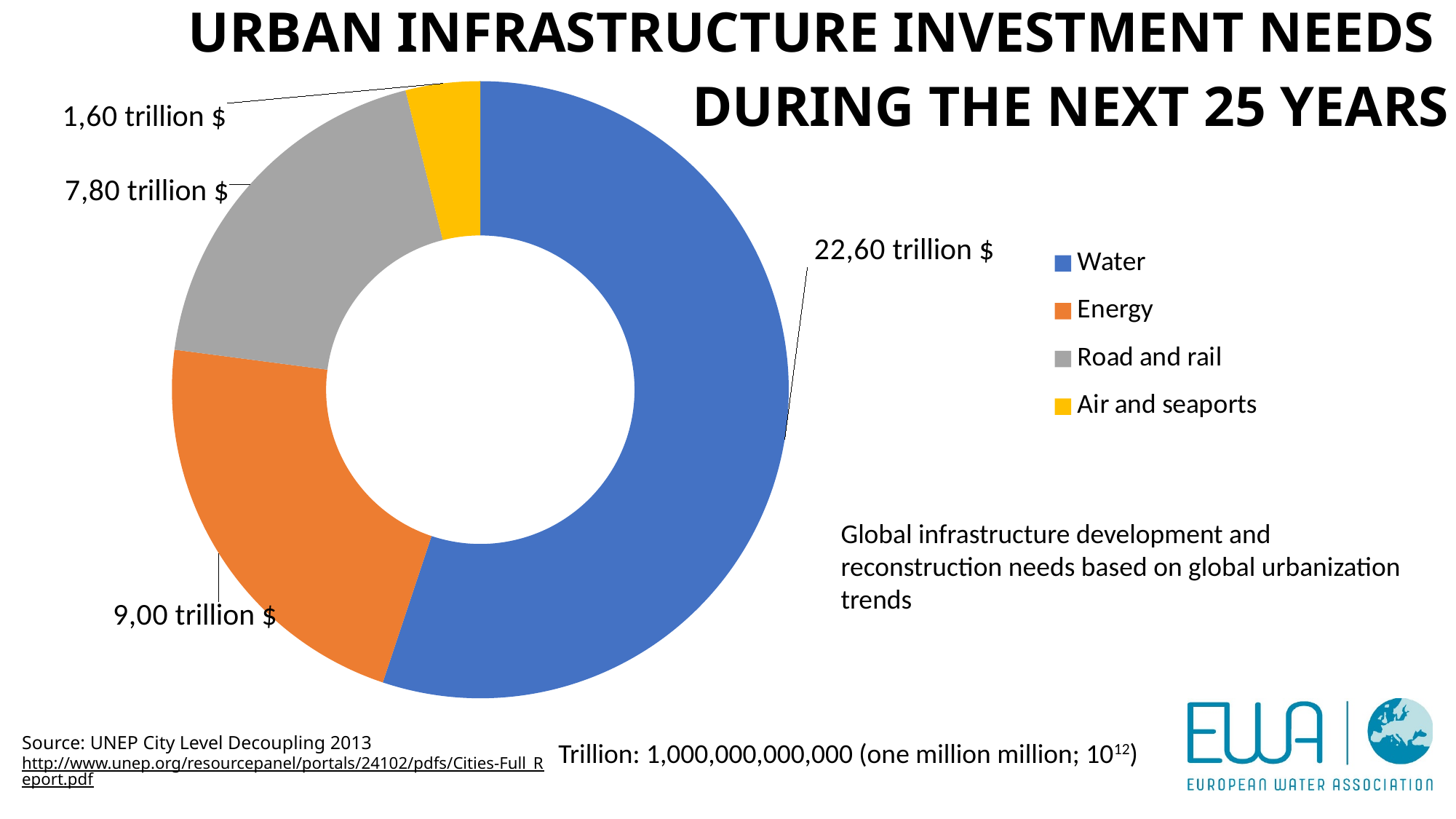
What is the investment need for Road and rail? 7,80 trillion $ What is the investment need for Air and seaports? 1,60 trillion $ What kind of chart is shown on the slide? Doughnut (pie) chart What is the investment need for Energy? 9,00 trillion $ Which category has the smallest investment need? Air and seaports What colour represents Road and rail in the chart? Grey What is the investment need for Water? 22,60 trillion $ Which category has the largest investment need? Water How many categories are shown in the chart? 4 What is the difference between the investment needs for Road and rail and Air and seaports? 6,20 trillion $ How much larger is the investment need for Water than for Energy? 13,60 trillion $ Which has the larger investment need, Energy or Road and rail? Energy